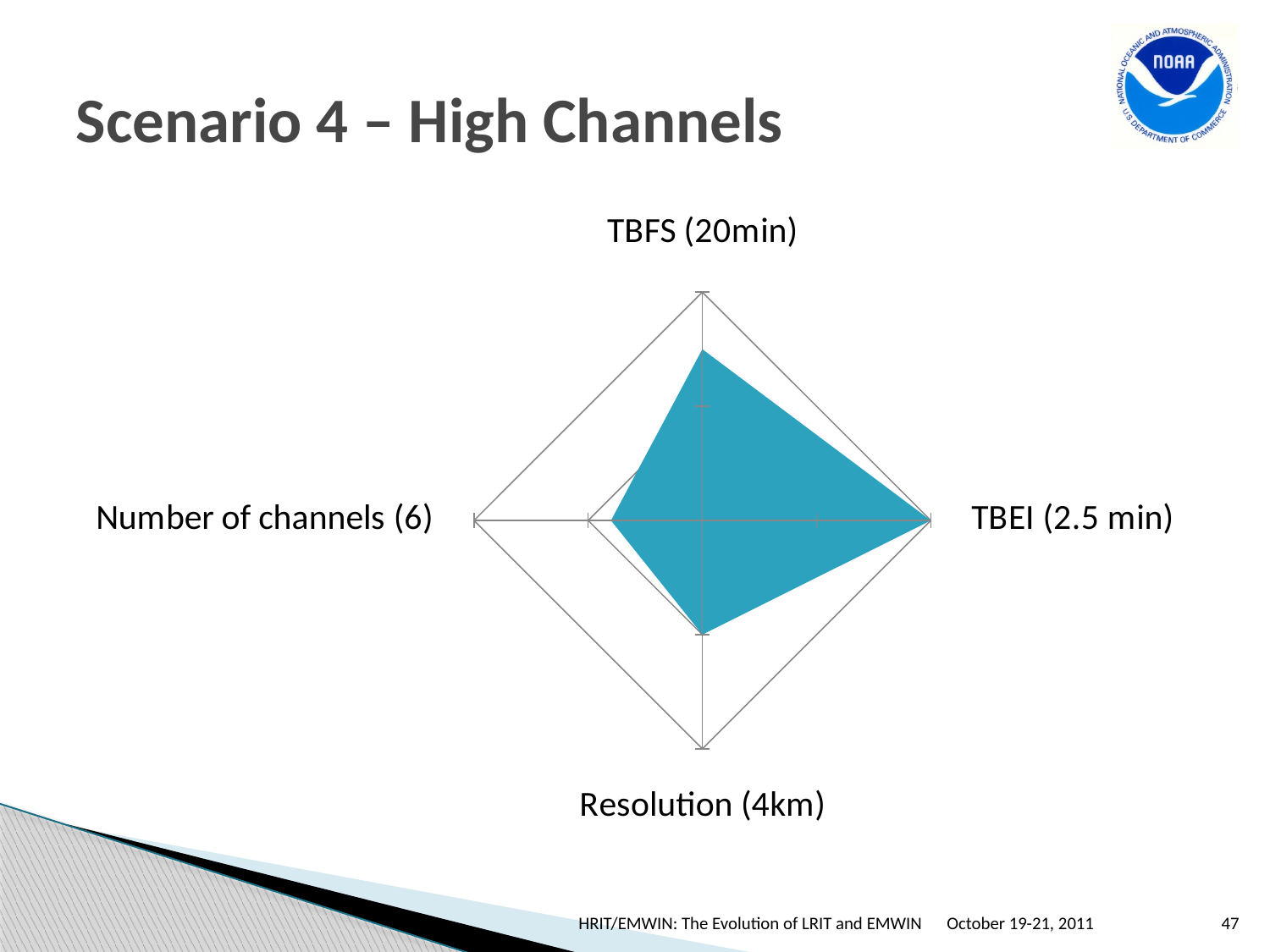
On which axis does the plotted shape extend least from the centre? Number of channels (6) What kind of chart is shown on the slide? Radar chart On which axis does the plotted shape extend furthest from the centre? TBEI (2.5 min) Which axis label appears at the top of the radar chart? TBFS (20min) Which extends further from the centre: the TBEI (2.5 min) axis or the Number of channels (6) axis? TBEI (2.5 min) What colour is the filled area of the radar chart? Blue (teal) What is the title of the slide containing the radar chart? Scenario 4 – High Channels How many axes (categories) does the radar chart have? 4 Which extends further from the centre: the TBFS (20min) axis or the Resolution (4km) axis? TBFS (20min)